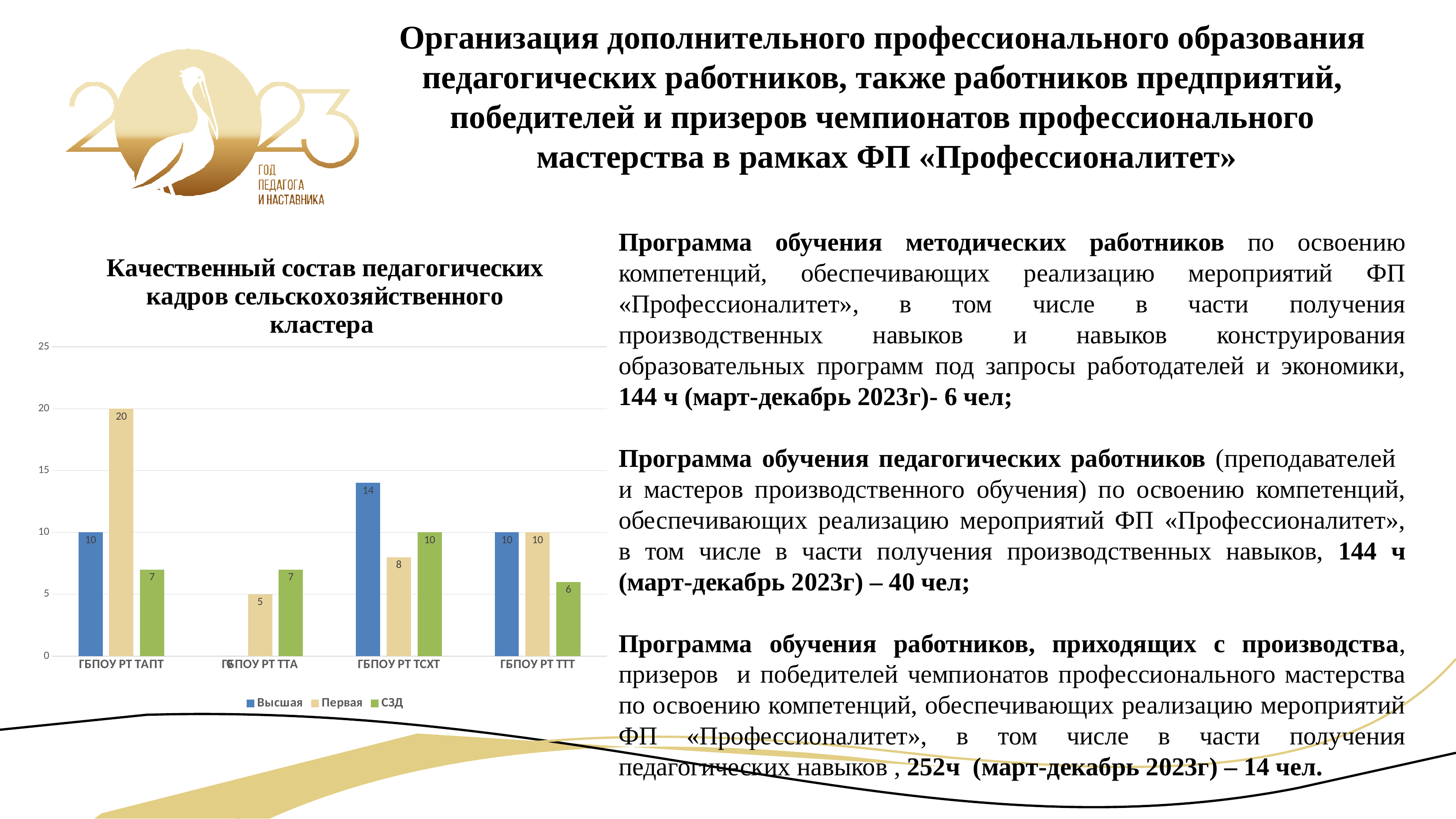
Which category has the lowest value for the Первая series? ГБПОУ РТ ТТА How many categories are shown on the x axis of the chart? 4 What is the value of Первая for ГБПОУ РТ ТТА? 5 What type of chart is shown on the slide? bar chart What is the value of СЗД for ГБПОУ РТ ТТТ? 6 What is the value of Первая for ГБПОУ РТ ТАПТ? 20 Is the Первая value for ГБПОУ РТ ТАПТ greater or less than 15? greater What is the value of Высшая for ГБПОУ РТ ТСХТ? 14 What is the difference between the Первая value for ГБПОУ РТ ТАПТ and the Первая value for ГБПОУ РТ ТСХТ? 12 Which is larger: the СЗД value for ГБПОУ РТ ТСХТ or the СЗД value for ГБПОУ РТ ТАПТ? ГБПОУ РТ ТСХТ Which category has the highest value for the Высшая series? ГБПОУ РТ ТСХТ How many series does the chart legend list? 3